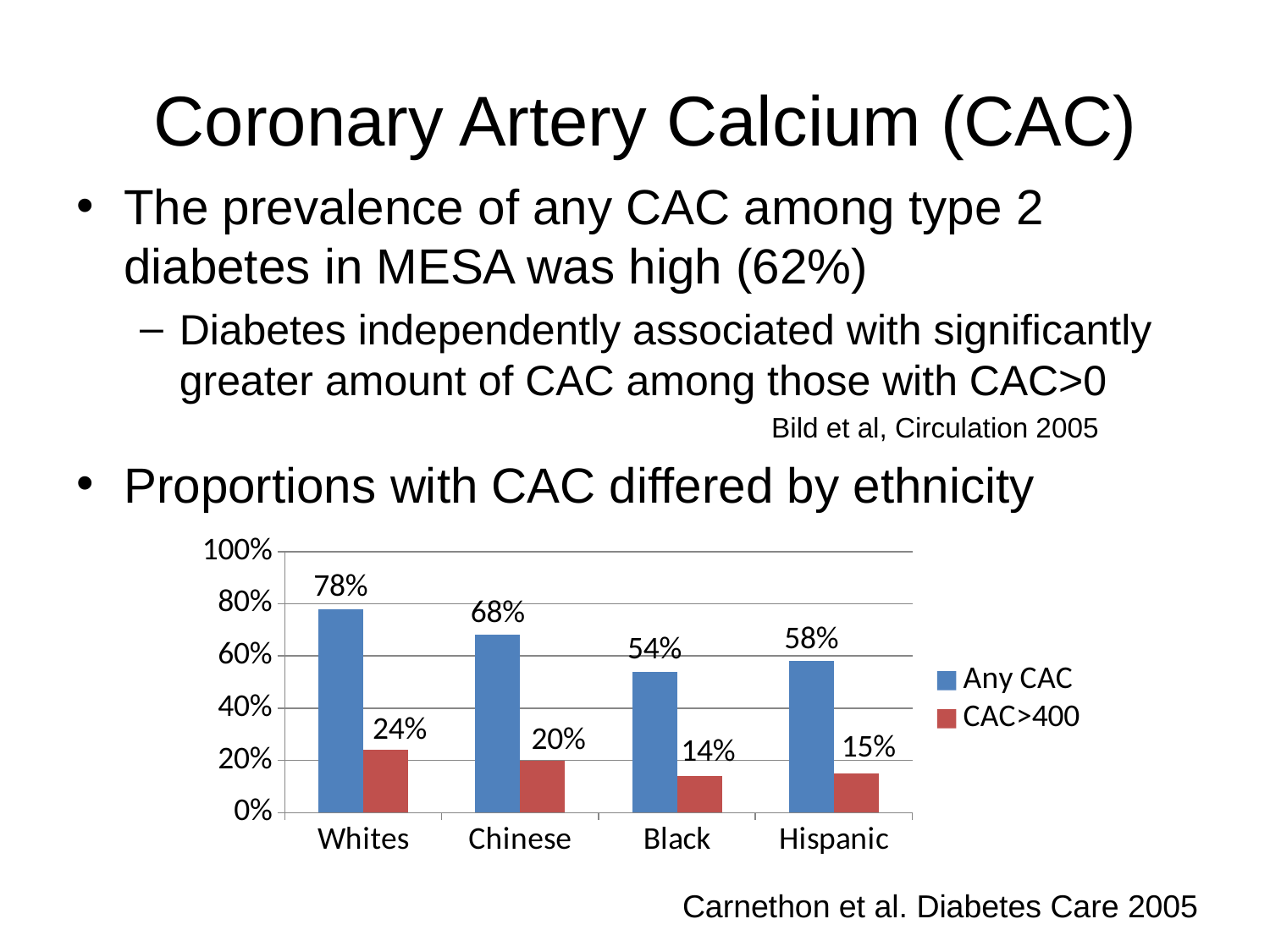
How many series does the chart legend list? 2 Which is larger, the CAC>400 value for Whites or for Hispanic? Whites How many ethnic groups are shown on the x axis of the chart? 4 What is the Any CAC value for Hispanic? 58% Which ethnic group has the lowest Any CAC value? Black What is the CAC>400 value for Chinese? 20% What is the difference between the Any CAC values for Whites and Chinese? 10% What is the Any CAC value for Whites? 78% Which ethnic group has the highest Any CAC value? Whites What is the CAC>400 value for Black? 14% Which ethnic group has the lowest CAC>400 value? Black What kind of chart is shown on the slide? Bar chart